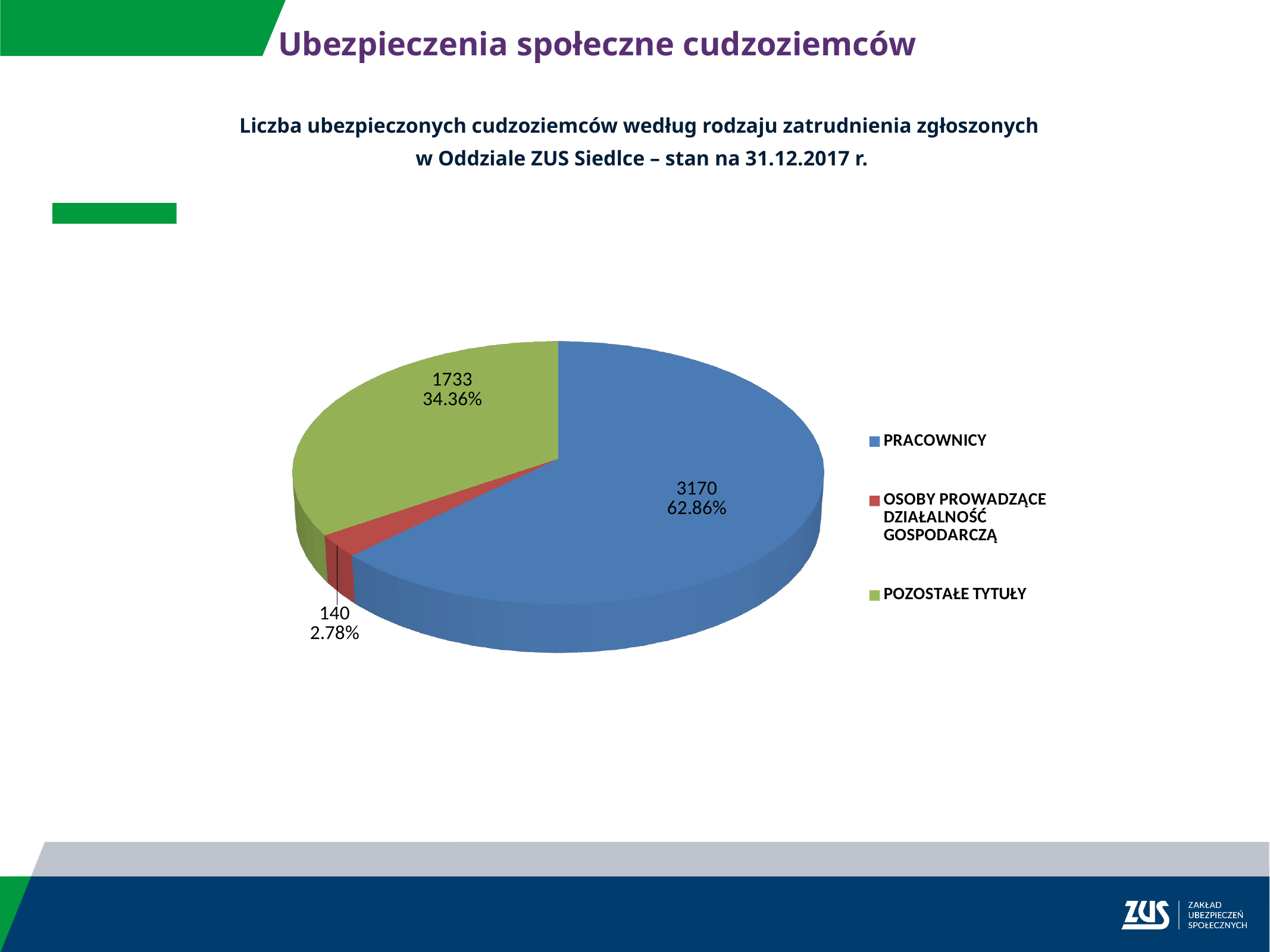
What share of the pie does PRACOWNICY represent? 62.86% What share of the pie does OSOBY PROWADZĄCE DZIAŁALNOŚĆ GOSPODARCZĄ represent? 2.78% How many categories does the pie chart have? 3 What is the value for POZOSTAŁE TYTUŁY? 1733 Which category has the smallest slice? OSOBY PROWADZĄCE DZIAŁALNOŚĆ GOSPODARCZĄ What share of the pie does POZOSTAŁE TYTUŁY represent? 34.36% Which category has the largest slice? PRACOWNICY What is the value for OSOBY PROWADZĄCE DZIAŁALNOŚĆ GOSPODARCZĄ? 140 What colour is the slice for POZOSTAŁE TYTUŁY? Green How many insured foreigners are in the PRACOWNICY category? 3170 What is the difference between the values for PRACOWNICY and POZOSTAŁE TYTUŁY? 1437 What type of chart is shown on the slide? Pie chart